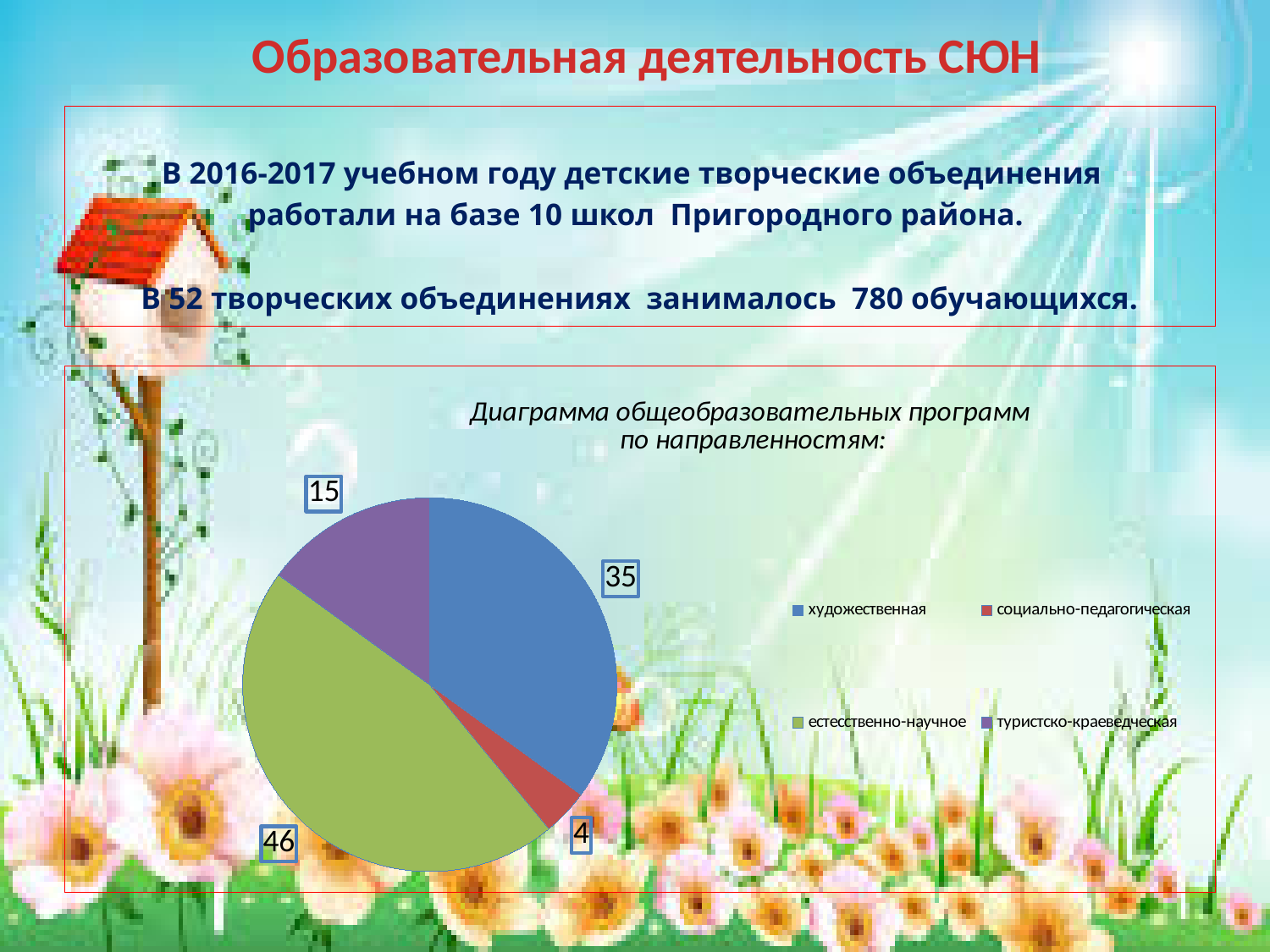
Which is larger, the value for художественная or the value for туристско-краеведческая? художественная What is the value for естественно-научное in the pie chart? 46 What share of the pie does the туристско-краеведческая slice represent? 15% How many categories does the pie chart show? 4 What is the value for социально-педагогическая in the pie chart? 4 Which category has the largest slice in the pie chart? естественно-научное Which category has the smallest slice in the pie chart? социально-педагогическая What is the value for туристско-краеведческая in the pie chart? 15 What is the title of the chart? Диаграмма общеобразовательных программ по направленностям: What kind of chart is shown on the slide? pie chart What is the difference between the values for естественно-научное and художественная? 11 What is the value for художественная in the pie chart? 35